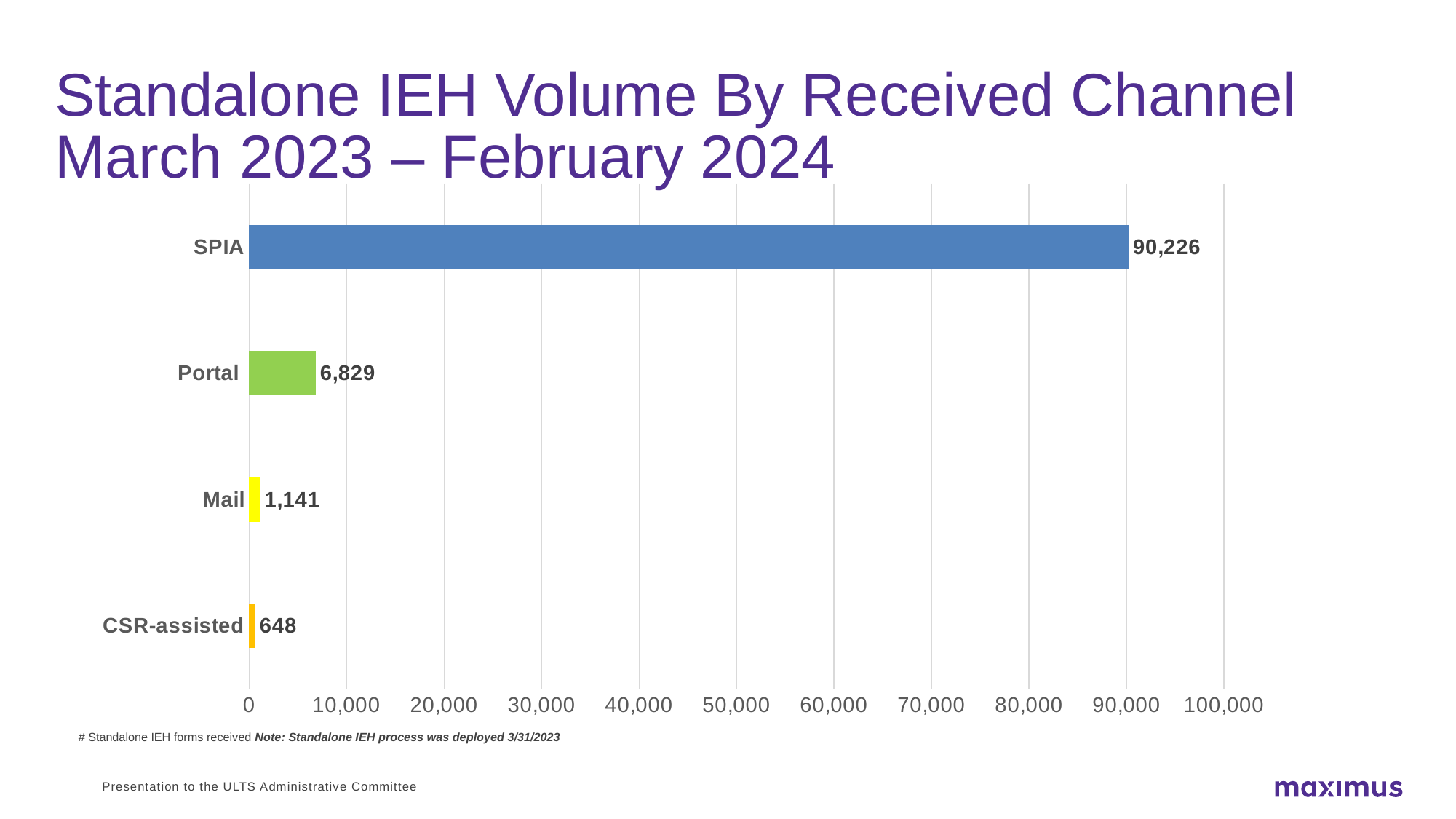
What is the difference between the Mail and CSR-assisted volumes? 493 Which received channel has the lowest Standalone IEH volume? CSR-assisted What is the Standalone IEH volume for the Portal channel? 6,829 What is the Standalone IEH volume for the SPIA channel? 90,226 What is the Standalone IEH volume for the Mail channel? 1,141 Is the value for SPIA greater or less than 80,000? greater How many received channels are shown in the chart? 4 Which channel has a larger volume, Portal or Mail? Portal What kind of chart is shown on the slide? Bar chart What is the difference between the SPIA and Portal volumes? 83,397 What is the Standalone IEH volume for the CSR-assisted channel? 648 Which received channel has the highest Standalone IEH volume? SPIA